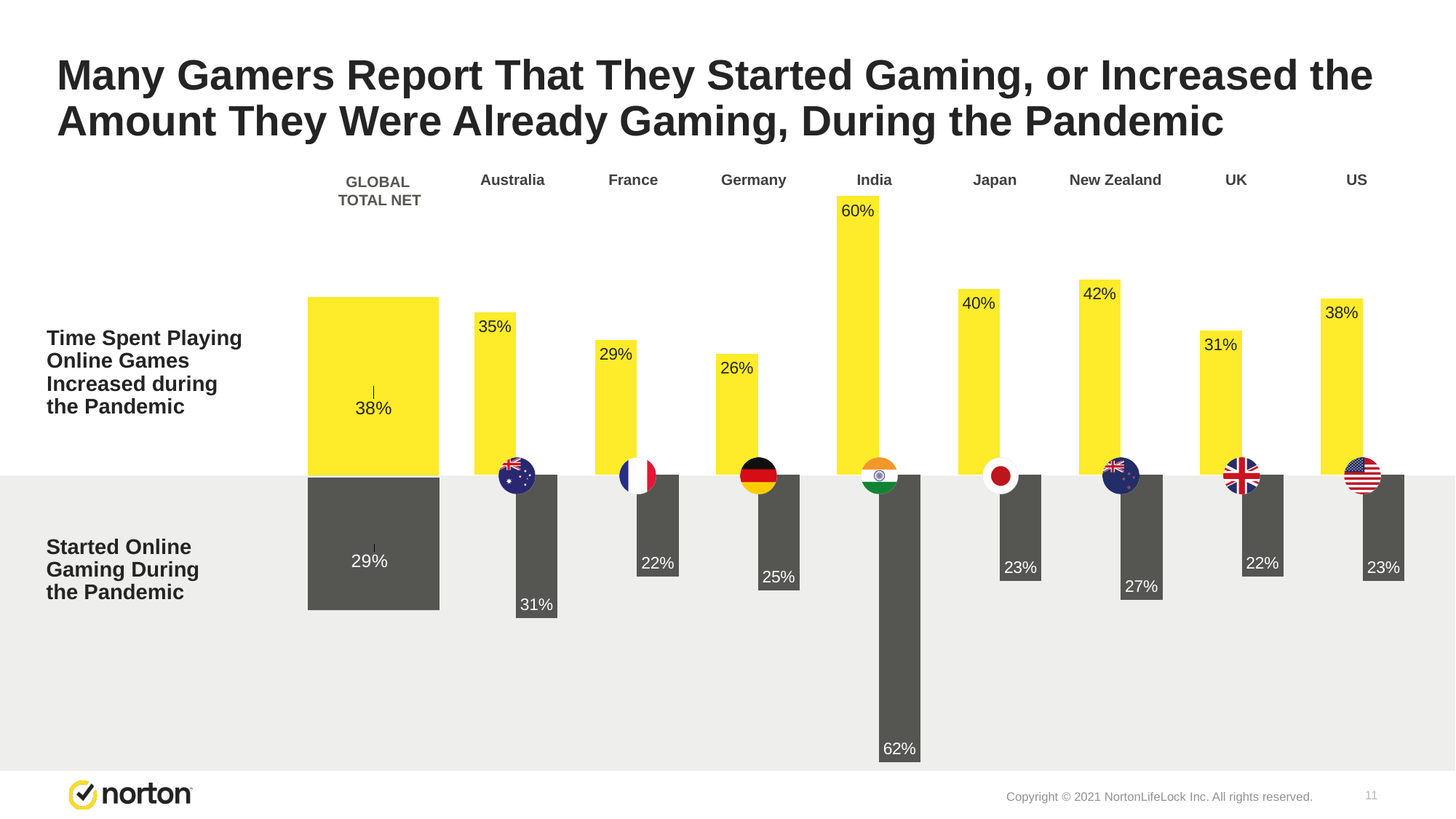
What percentage of gamers in India reported that their time spent playing online games increased during the pandemic? 60% What kind of chart is shown on the slide? Bar chart What percentage of gamers in New Zealand started online gaming during the pandemic? 27% Which country has the highest percentage of gamers who started online gaming during the pandemic? India Which is larger: the percentage of gamers in Australia or in the UK whose time spent playing online games increased during the pandemic? Australia What is the Global Total Net value for gamers who started online gaming during the pandemic? 29% Which country has the highest percentage of gamers whose time spent playing online games increased during the pandemic? India How many countries (excluding the Global Total Net) are shown in the chart? 8 What is the difference between India's and Japan's percentages for time spent playing online games increased during the pandemic? 20% Which country has the lowest percentage of gamers whose time spent playing online games increased during the pandemic? Germany What is the difference between the Global Total Net values for time spent increased and started online gaming during the pandemic? 9% What colour are the bars for 'Time Spent Playing Online Games Increased during the Pandemic'? Yellow